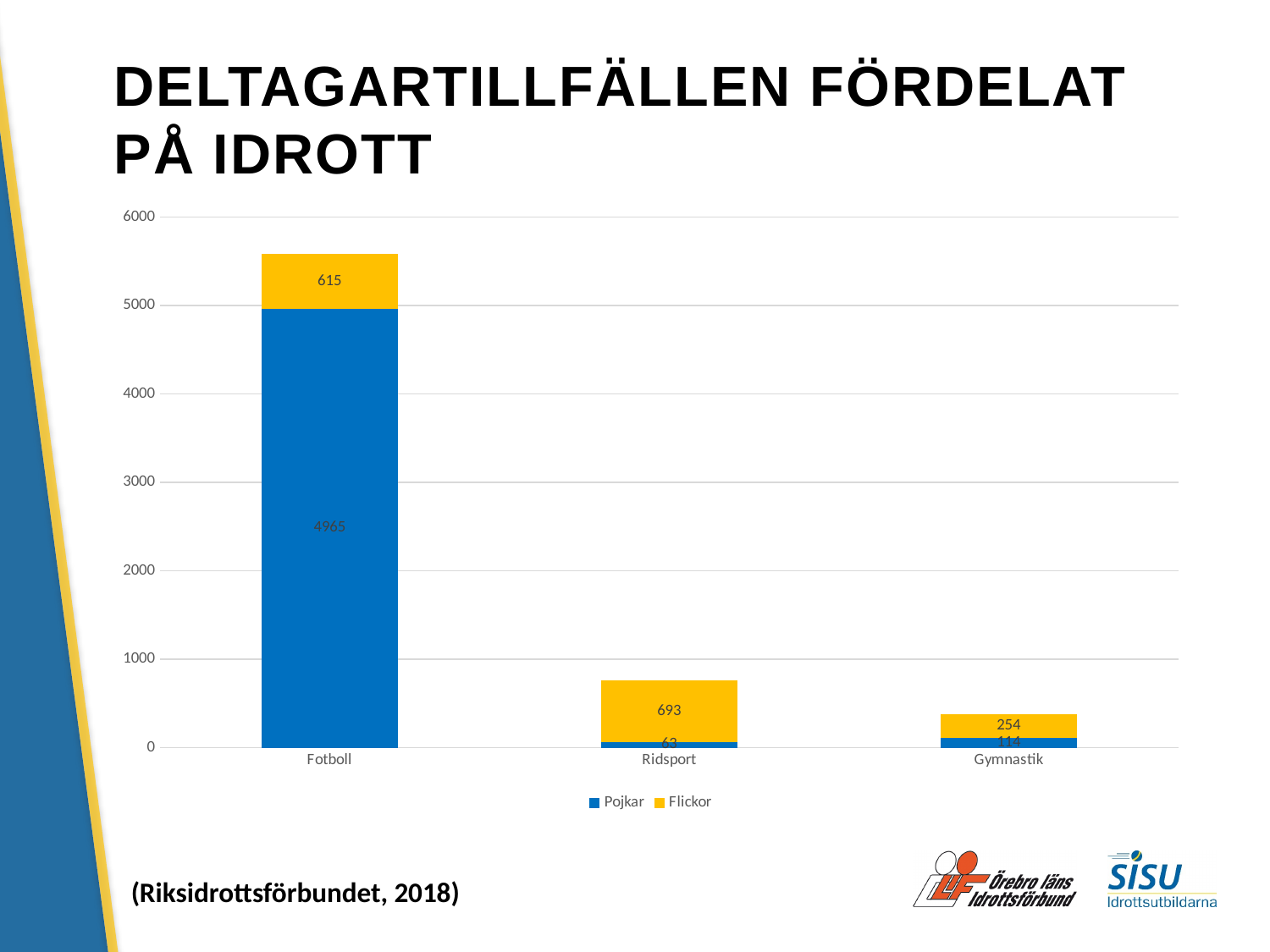
What is the Flickor value for Ridsport? 693 What is the Flickor value for Gymnastik? 254 How many categories are shown on the x axis? 3 Which is larger for Gymnastik, the Pojkar value or the Flickor value? Flickor Which category has the highest Pojkar value? Fotboll What is the total of the stacked bar for Fotboll? 5580 How many series does the legend list? 2 What is the Pojkar value for Gymnastik? 114 What is the Pojkar value for Fotboll? 4965 What is the difference between the Flickor values for Ridsport and Gymnastik? 439 Which category has the lowest Flickor value? Gymnastik What is the total of the stacked bar for Gymnastik? 368